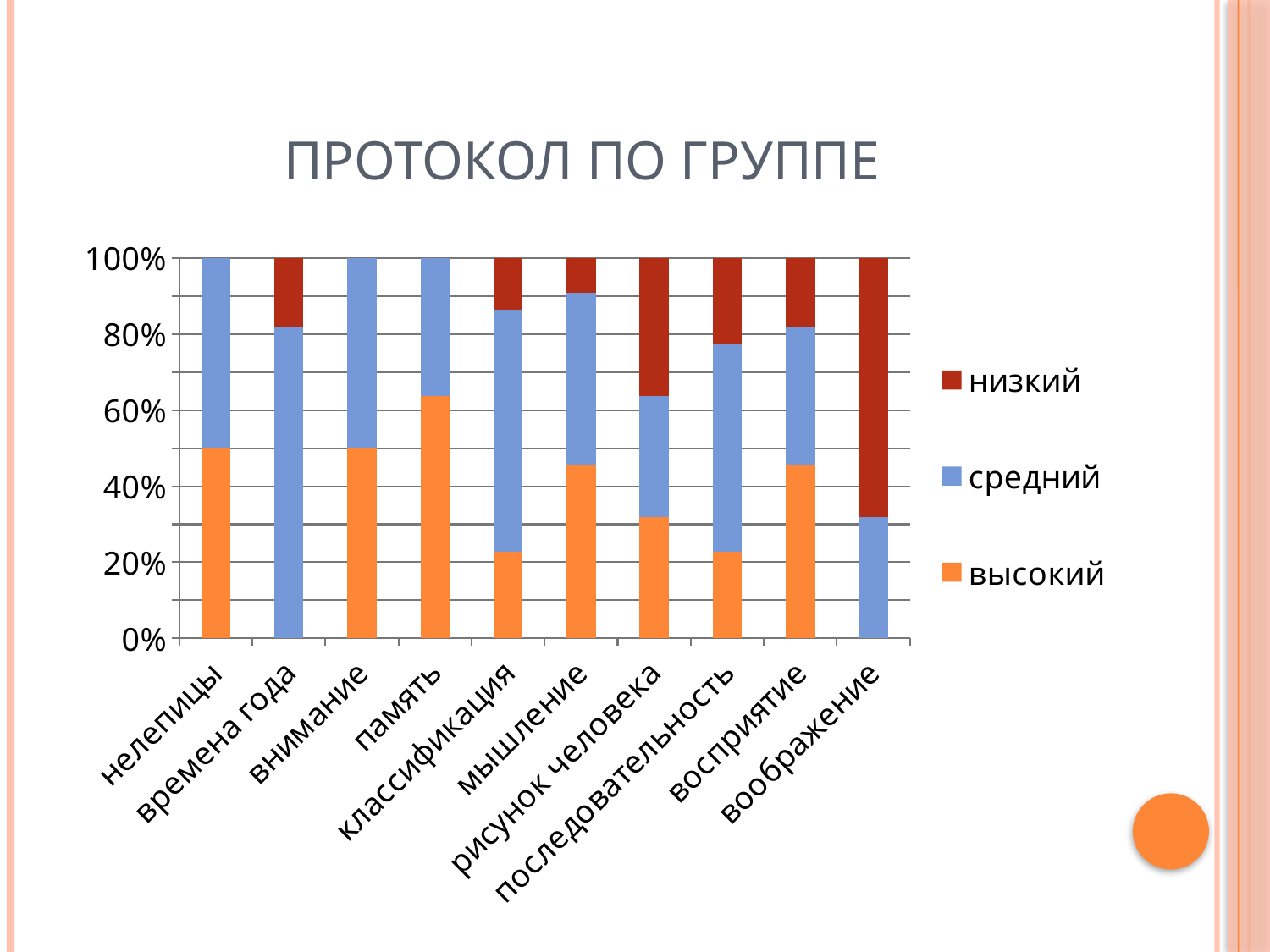
Which category has the largest "высокий" share? память What is the title of the chart? ПРОТОКОЛ ПО ГРУППЕ Is the "низкий" share for "рисунок человека" greater or less than 20%? greater Which is larger: the "высокий" share for "память" or for "классификация"? память Is the "высокий" share for "память" greater or less than 60%? greater Which colour represents the series "низкий" in the legend? dark red How many series does the legend list? 3 What kind of chart is shown on the slide? stacked bar chart Is the "низкий" share for "воображение" greater or less than 60%? greater Which category has the largest "низкий" share? воображение How many categories are shown on the x axis? 10